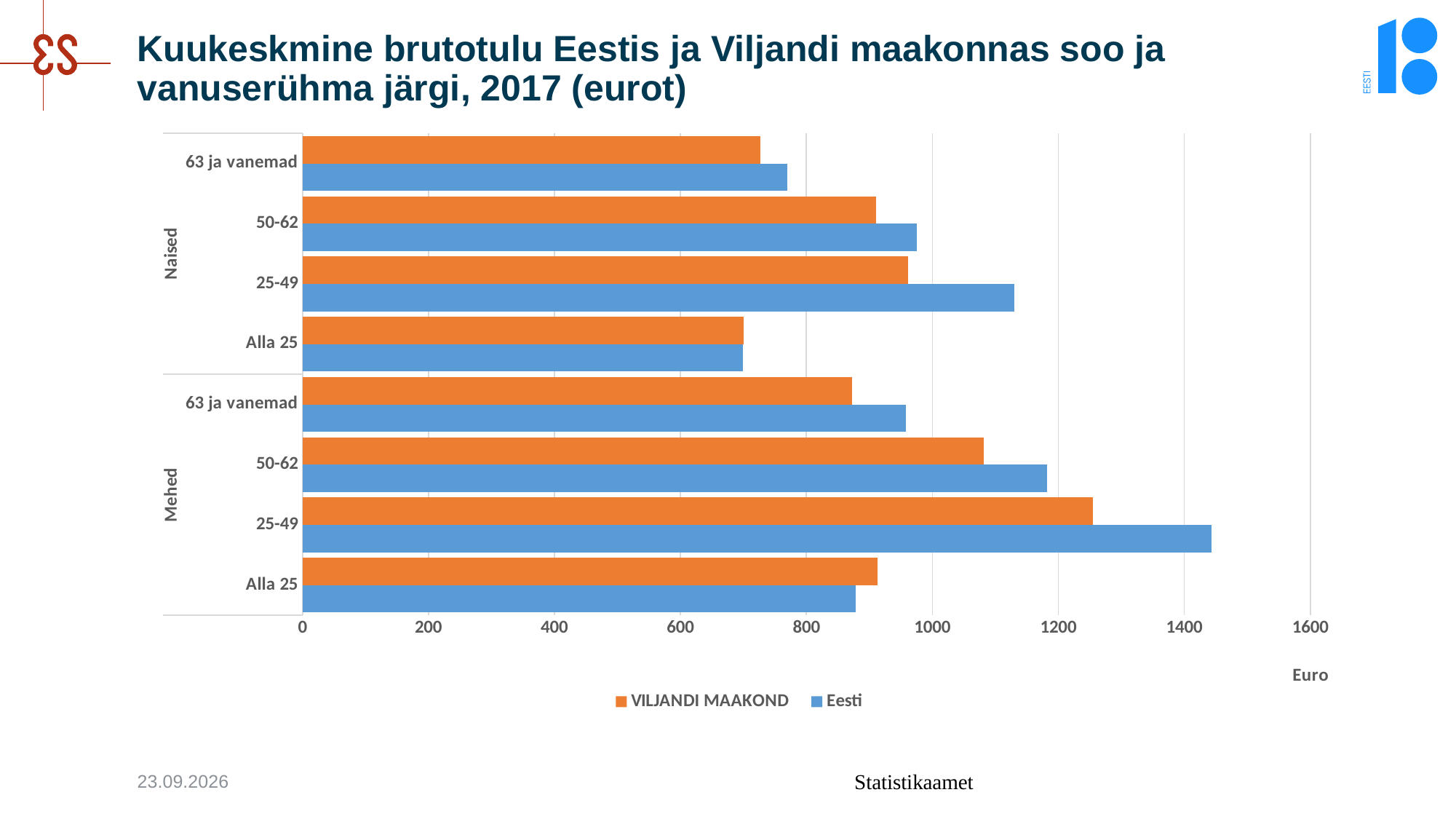
How many age-group categories are plotted in total across both genders? 8 Which category has the highest value for the Eesti series? Mehed 25-49 Is the Eesti value for Mehed 25-49 greater or less than 1400? greater Is the VILJANDI MAAKOND value for Mehed 25-49 greater or less than 1200? greater Is the Eesti value for Naised 25-49 greater or less than 1000? greater For Mehed 50-62, which series has the larger value, VILJANDI MAAKOND or Eesti? Eesti What kind of chart is shown on the slide? bar chart How many series does the legend list? 2 Which category has the lowest value for the Eesti series? Naised Alla 25 Which category has the highest value for the VILJANDI MAAKOND series? Mehed 25-49 What are the two series named in the legend? VILJANDI MAAKOND and Eesti